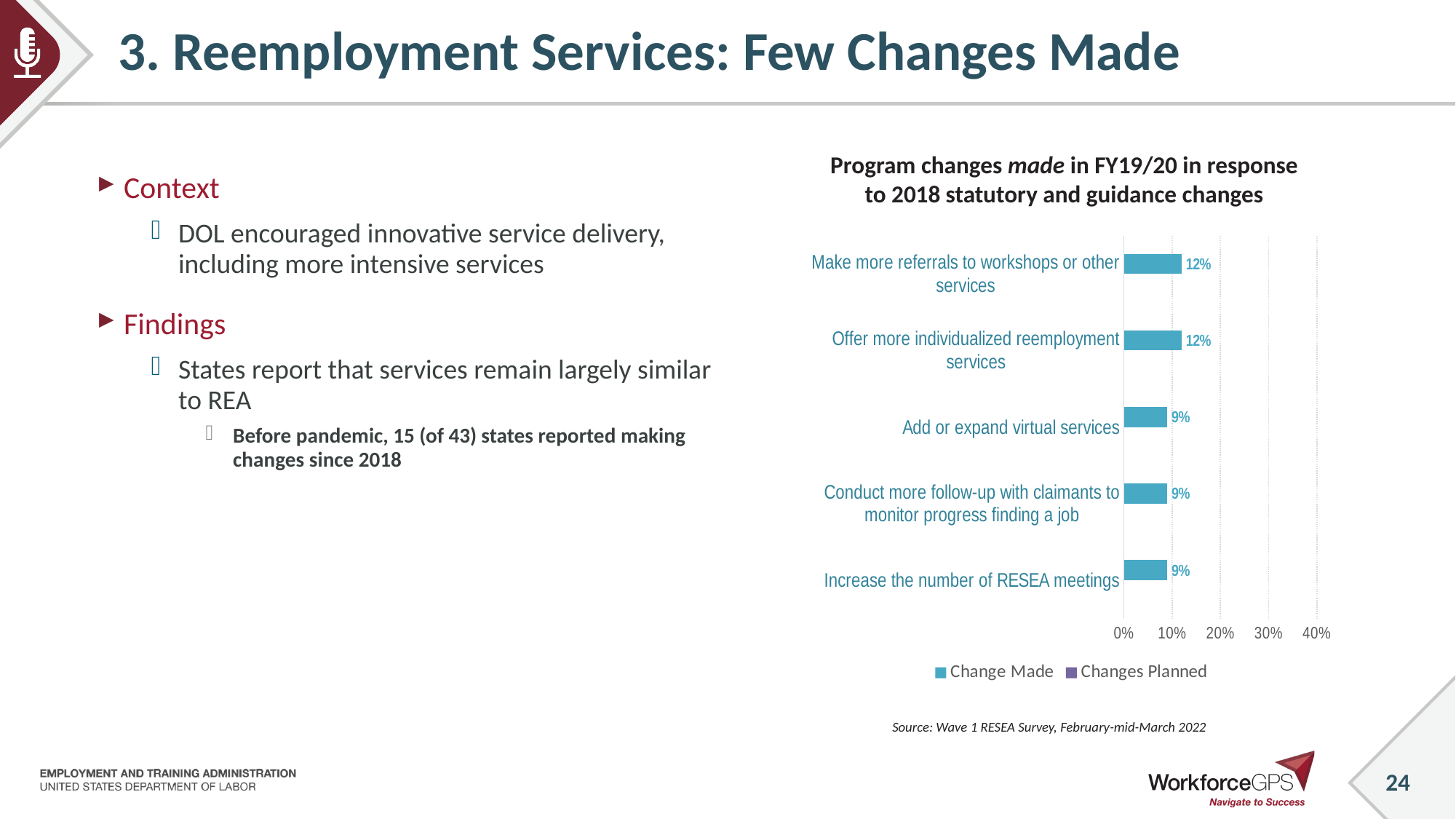
Is the value for "Increase the number of RESEA meetings" greater or less than 10%? less What are the two series named in the chart legend? Change Made and Changes Planned How many categories are shown in the chart? 5 What is the value for "Increase the number of RESEA meetings"? 9% What is the value for "Add or expand virtual services"? 9% What is the value for "Offer more individualized reemployment services"? 12% What is the value for "Make more referrals to workshops or other services"? 12% How many series does the legend list? 2 Which is larger: the value for "Offer more individualized reemployment services" or the value for "Add or expand virtual services"? Offer more individualized reemployment services What is the difference between the value for "Make more referrals to workshops or other services" and the value for "Conduct more follow-up with claimants to monitor progress finding a job"? 3 percentage points What kind of chart is shown on the slide? Bar chart Is the value for "Make more referrals to workshops or other services" greater or less than 10%? greater